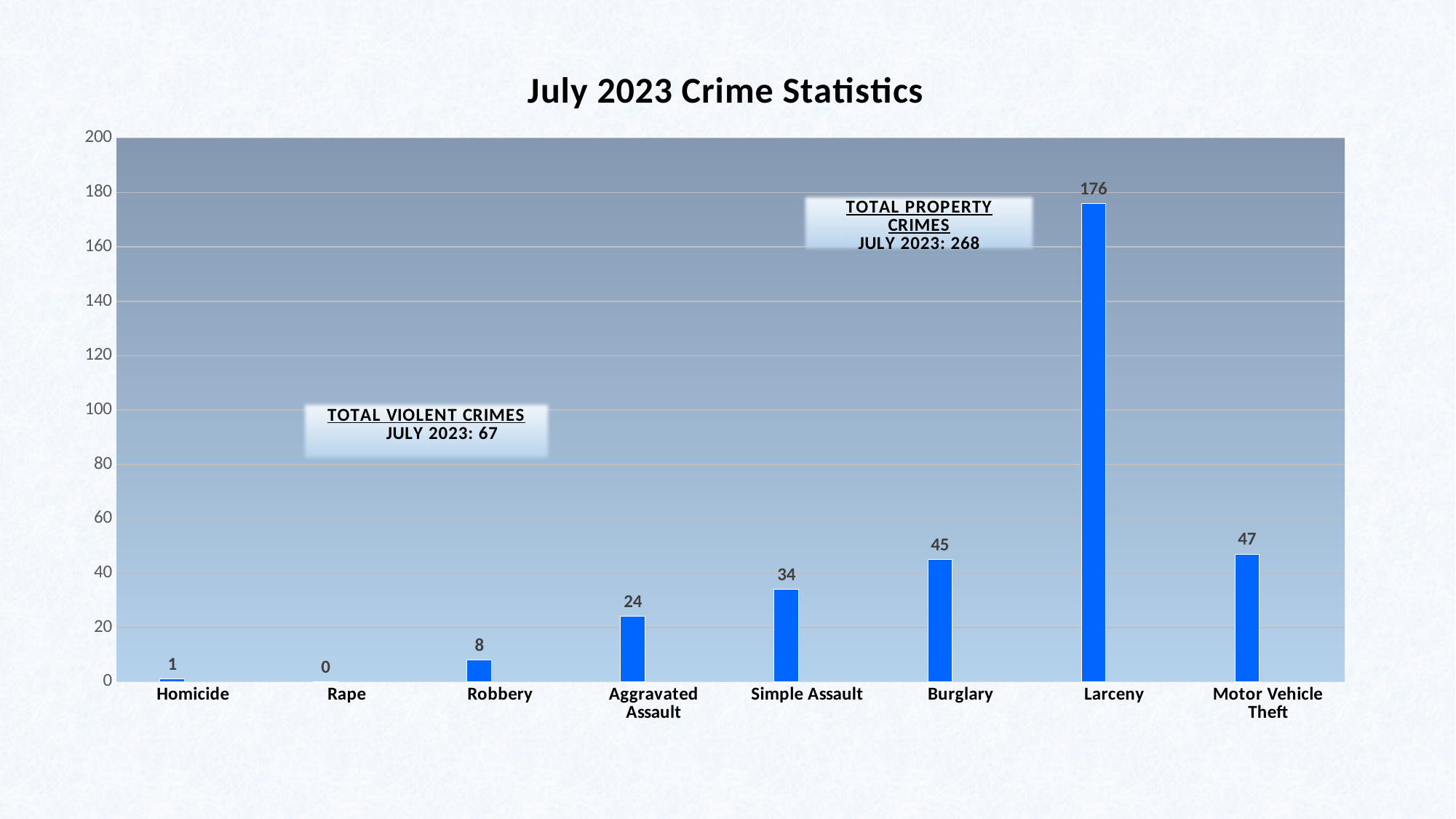
According to the text box on the chart, what is the total number of property crimes for July 2023? 268 Which category has the highest value? Larceny What kind of chart is shown on the slide? bar chart What is the title of the chart? July 2023 Crime Statistics How many categories are shown on the x axis? 8 Which category has the lowest value? Rape What is the value for Larceny? 176 What is the value for Aggravated Assault? 24 Is the value for Larceny greater or less than 160? greater Which is larger, the value for Motor Vehicle Theft or the value for Burglary? Motor Vehicle Theft What is the value for Motor Vehicle Theft? 47 What is the difference between the values for Burglary and Simple Assault? 11